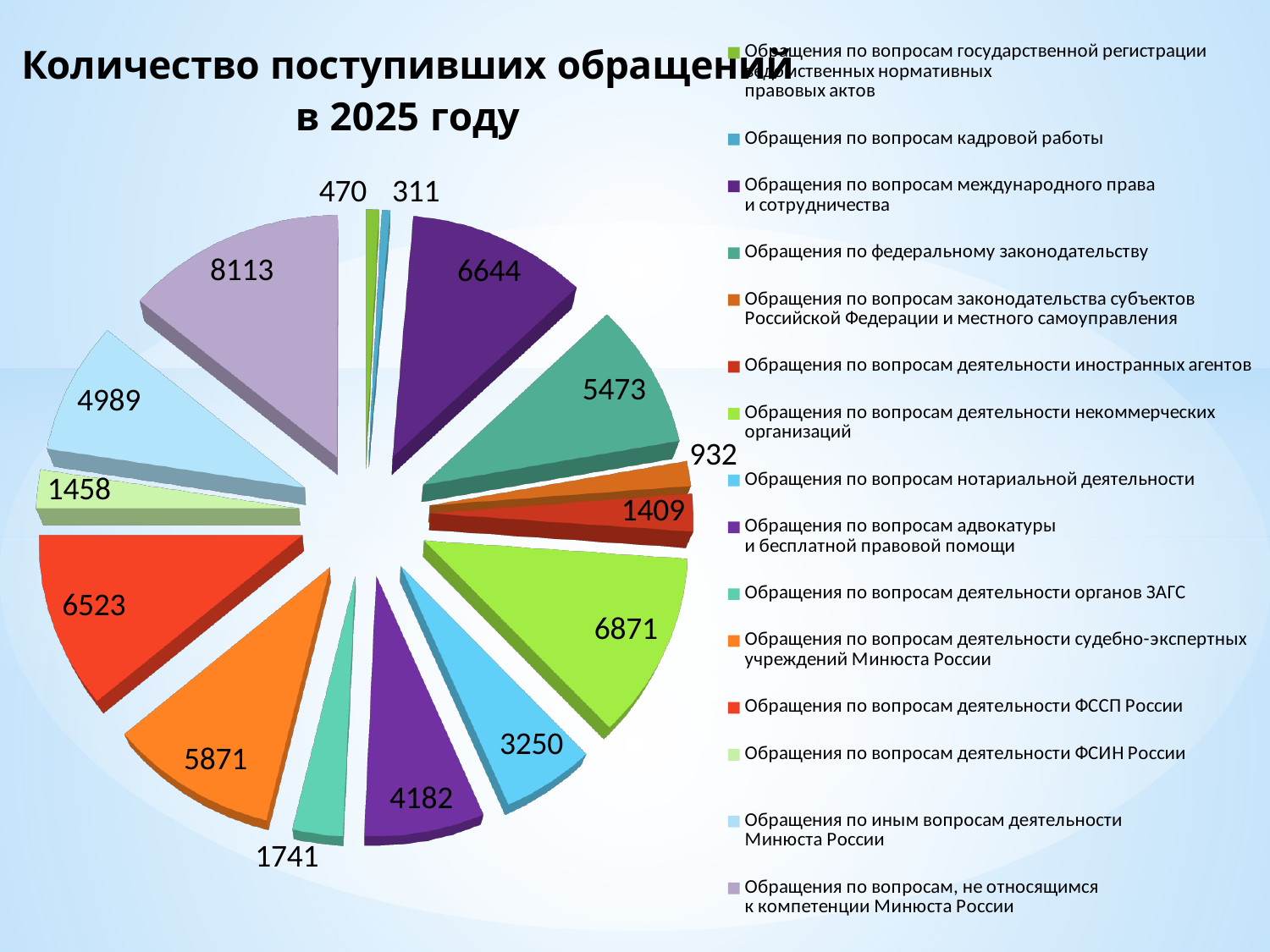
What is the difference between the values for "Обращения по иным вопросам деятельности Минюста России" and "Обращения по вопросам деятельности ФСИН России"? 3531 Which category has the largest value? Обращения по вопросам, не относящимся к компетенции Минюста России What is the title of the chart? Количество поступивших обращений в 2025 году What is the value for "Обращения по вопросам деятельности ФССП России"? 6523 Which category has the smallest value? Обращения по вопросам кадровой работы What is the value for "Обращения по вопросам деятельности органов ЗАГС"? 1741 What type of chart is shown on the slide? Pie chart What is the difference between the values for "Обращения по вопросам деятельности некоммерческих организаций" and "Обращения по вопросам международного права и сотрудничества"? 227 What is the value for "Обращения по вопросам деятельности иностранных агентов"? 1409 Which is larger: the value for "Обращения по федеральному законодательству" or the value for "Обращения по вопросам деятельности судебно-экспертных учреждений Минюста России"? Обращения по вопросам деятельности судебно-экспертных учреждений Минюста России How many categories does the legend list? 15 What is the value for "Обращения по вопросам нотариальной деятельности"? 3250